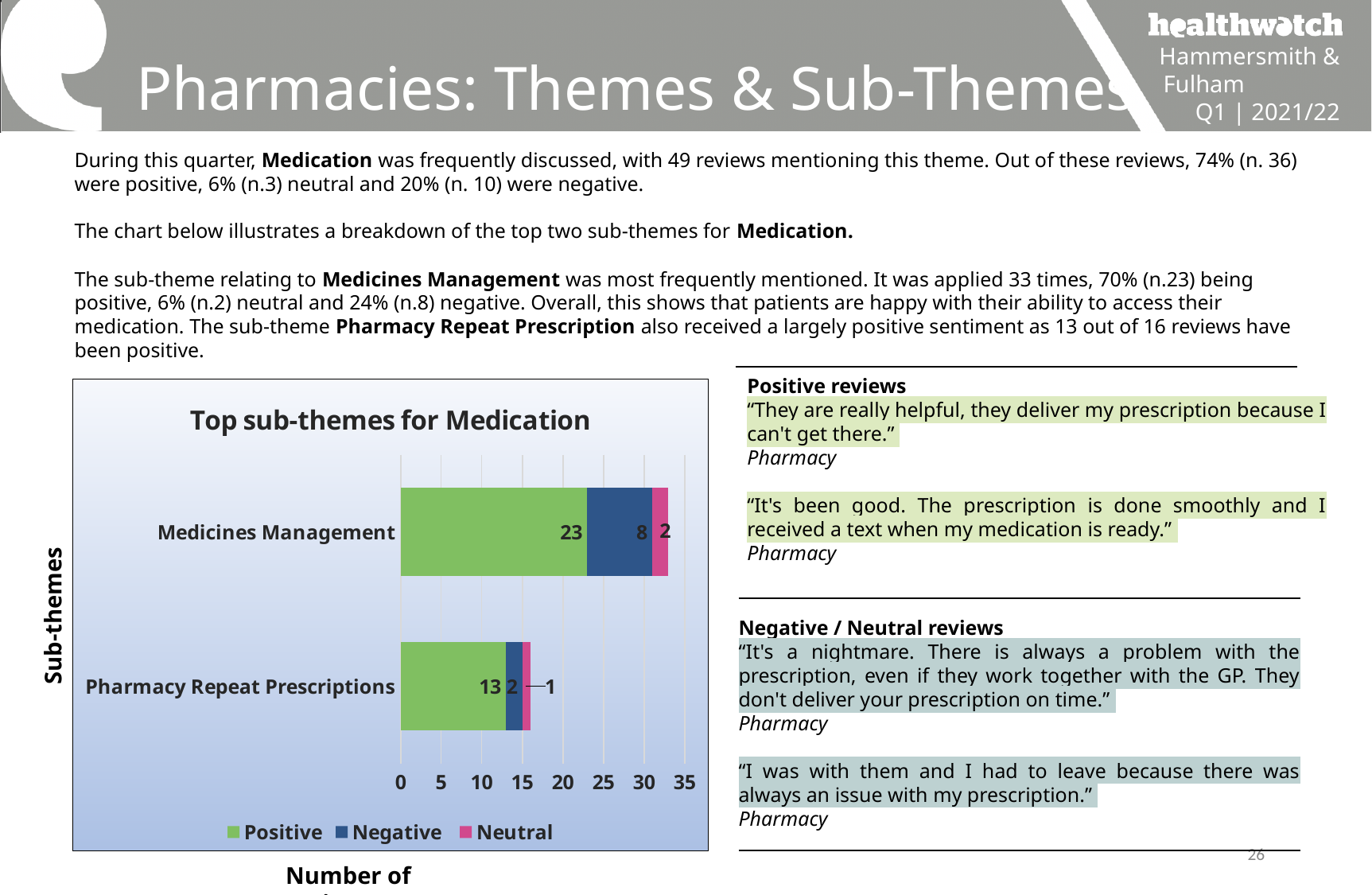
What is the total of the stacked bar for Pharmacy Repeat Prescriptions? 16 How many sub-themes are plotted in the chart? 2 How many series does the chart legend list? 3 What is the Positive value for Pharmacy Repeat Prescriptions? 13 What is the total of the stacked bar for Medicines Management? 33 Which sub-theme has the higher Negative value, Medicines Management or Pharmacy Repeat Prescriptions? Medicines Management What type of chart is shown on the slide? Stacked bar chart What is the Negative value for Medicines Management? 8 What is the difference between the Positive values for Medicines Management and Pharmacy Repeat Prescriptions? 10 What is the Neutral value for Pharmacy Repeat Prescriptions? 1 What is the title of the chart? Top sub-themes for Medication What is the Positive value for Medicines Management? 23